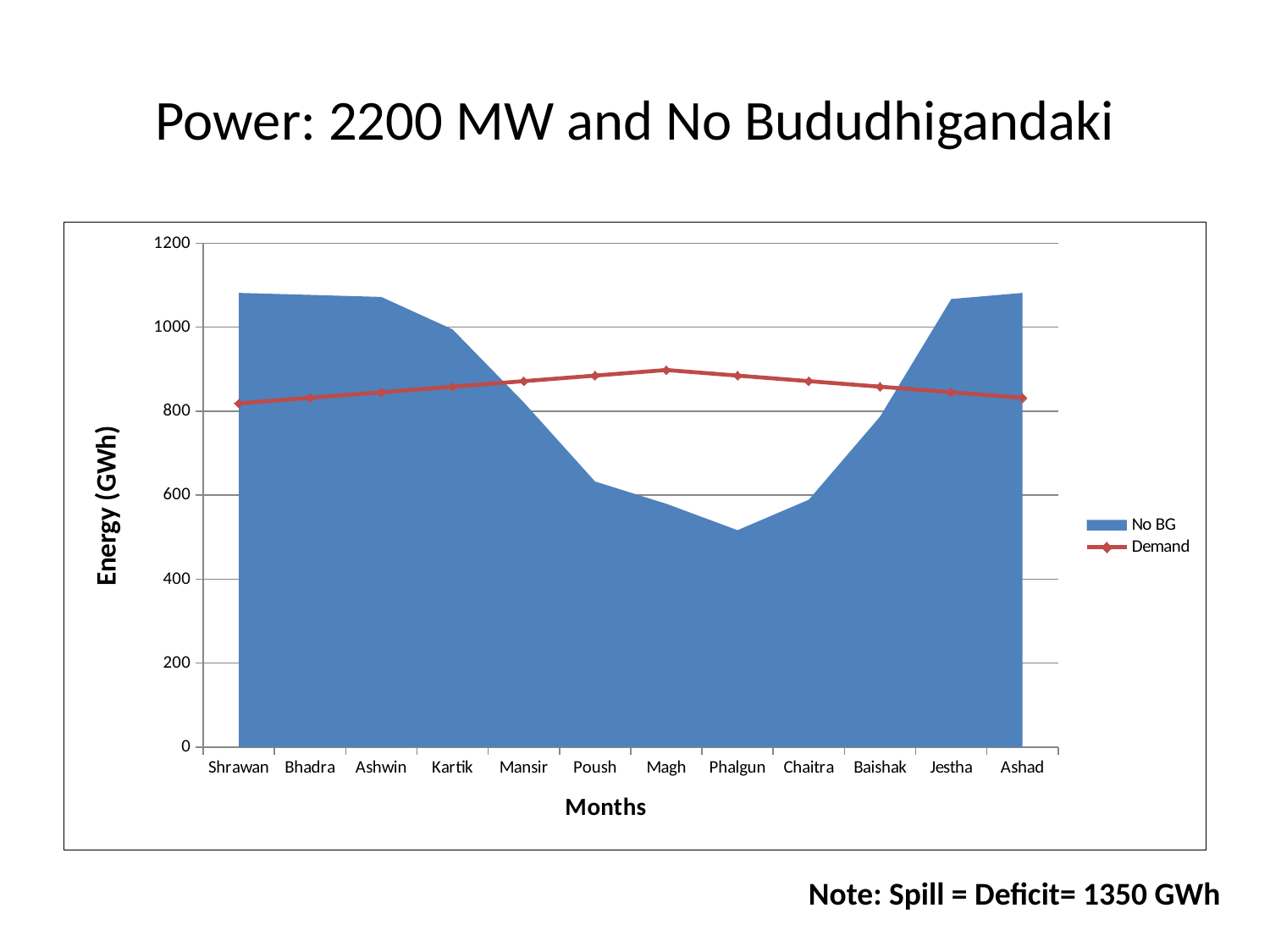
Is the Demand value for Magh greater or less than 800? greater What is the label of the y axis? Energy (GWh) In Magh, which is larger, No BG or Demand? Demand In Shrawan, which is larger, No BG or Demand? No BG Which month has the highest Demand value? Magh Is the No BG value for Phalgun greater or less than 600? less How many months are shown along the x axis? 12 Which month has the lowest No BG value? Phalgun What kind of chart is shown on the slide? An area chart with a line series How many series does the legend list? 2 Does the No BG value rise or fall from Shrawan to Phalgun? fall Is the No BG value for Shrawan greater or less than 1000? greater